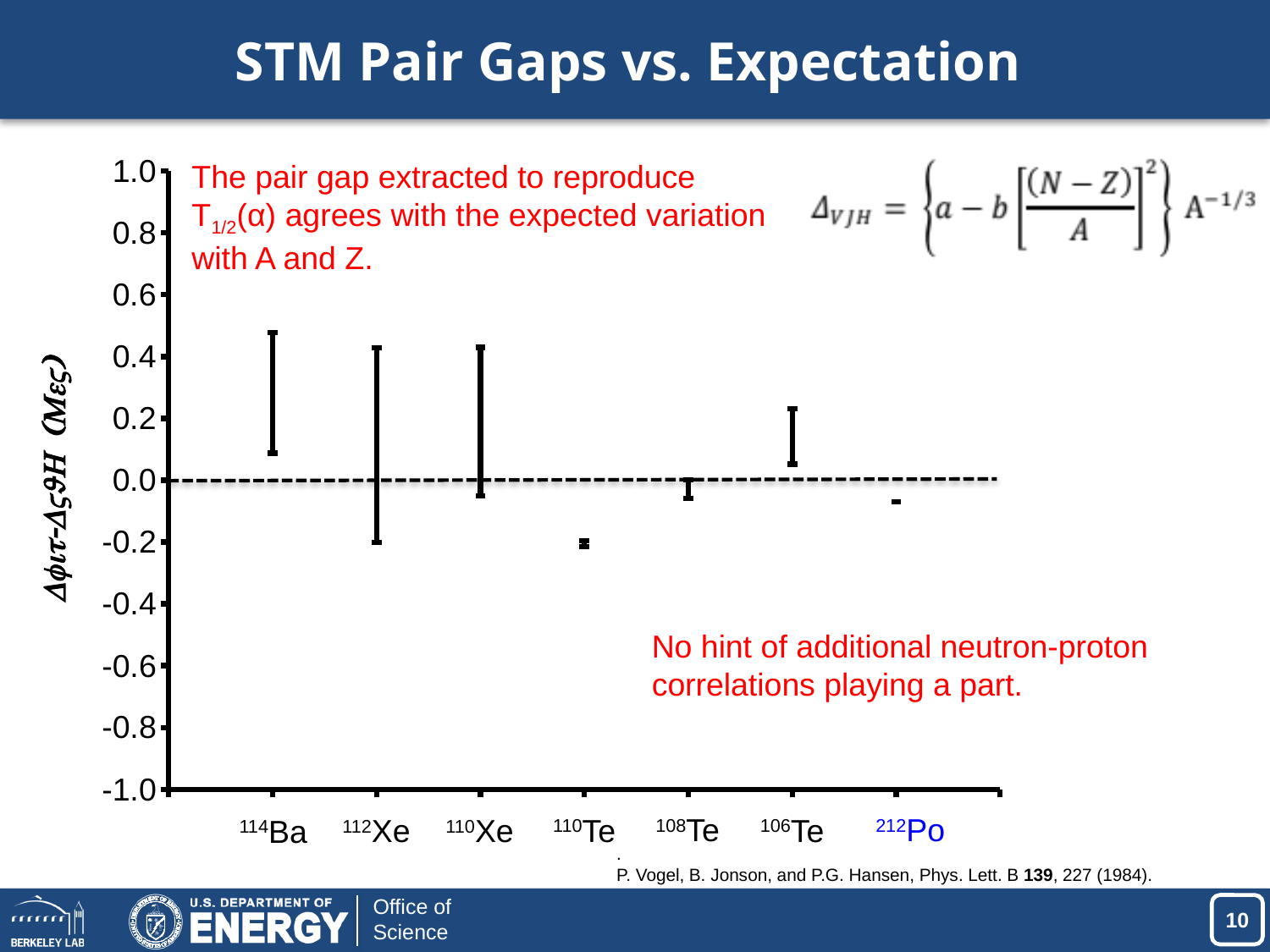
Is the value for 114Ba greater or less than 0.0? greater Is the value for 212Po greater or less than 0.0? less Which has the larger value, 110Te or 212Po? 212Po Which has the larger value, 110Te or 106Te? 106Te Which x-axis label is shown in blue rather than black? 212Po Which isotope has the longest error bar in the chart? 112Xe What is the highest tick value shown on the y axis? 1.0 Is the value for 106Te greater or less than 0.0? greater What is the title of the slide containing the chart? STM Pair Gaps vs. Expectation How many isotopes are plotted along the x axis of the chart? 7